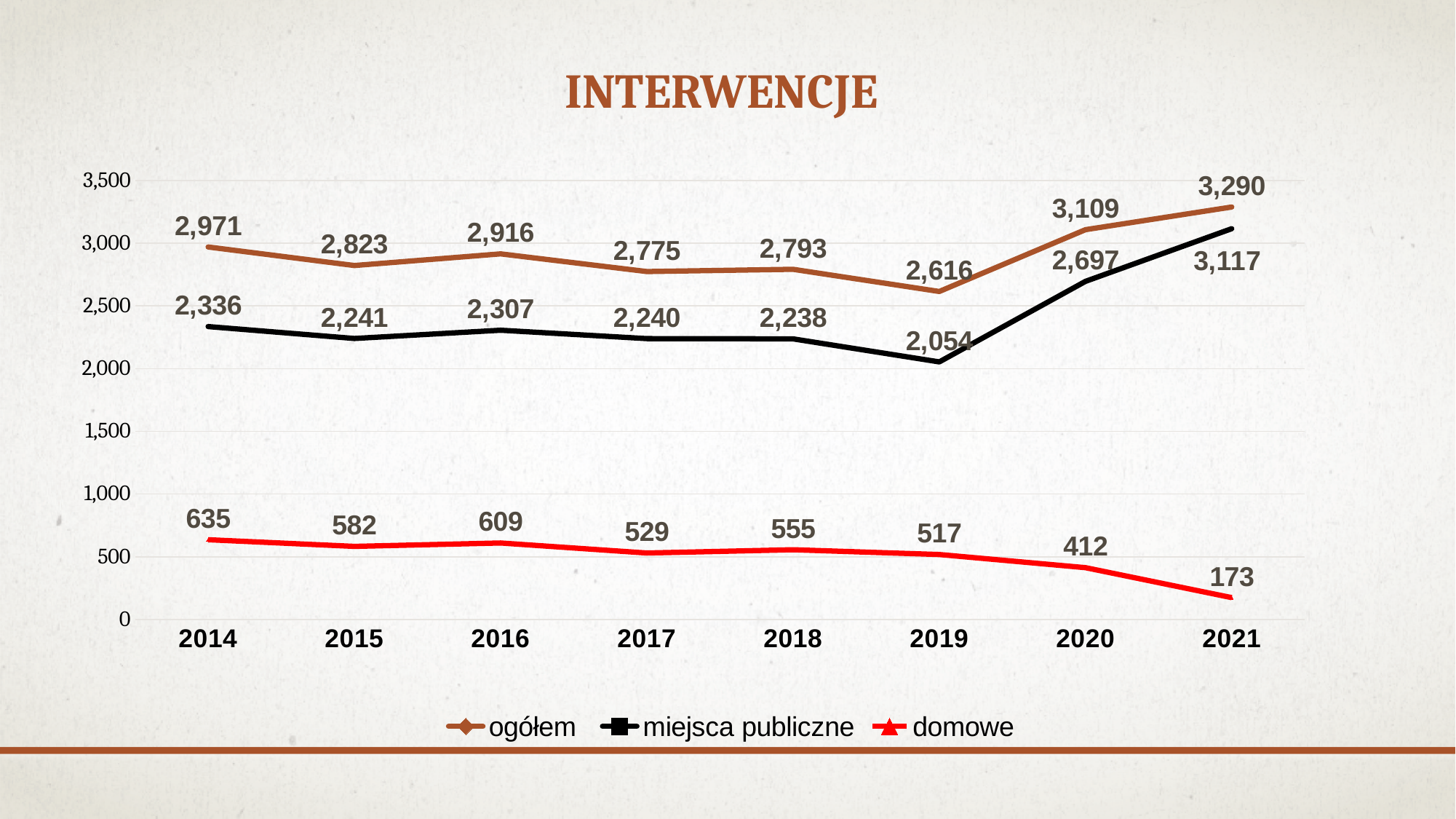
In which year is the domowe series highest? 2014 Which is larger: domowe in 2018 or domowe in 2019? domowe in 2018 Does the domowe series rise or fall from 2019 to 2021? fall How many series does the legend list? 3 Is the value for miejsca publiczne in 2021 greater or less than 3,000? greater What is the value for ogółem in 2021? 3,290 What is the value for domowe in 2014? 635 What is the difference between ogółem and miejsca publiczne in 2020? 412 What kind of chart is shown on the slide? line chart In which year is the ogółem series lowest? 2019 What is the value for miejsca publiczne in 2019? 2,054 How many years are shown on the x axis? 8